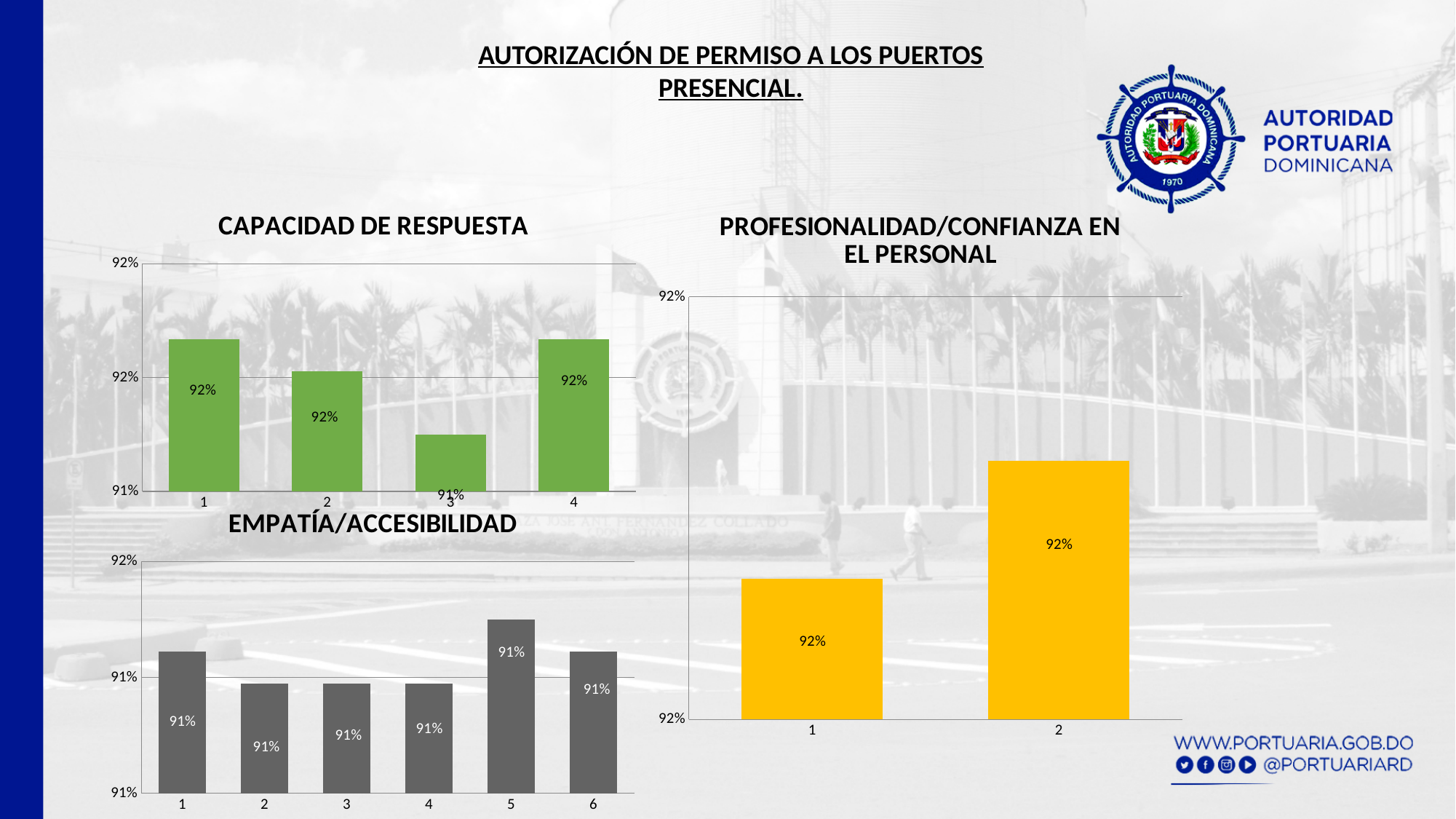
In the EMPATÍA/ACCESIBILIDAD chart, what is the value for category 6? 91% In the PROFESIONALIDAD/CONFIANZA EN EL PERSONAL chart, which bar is taller, category 1 or category 2? 2 In the EMPATÍA/ACCESIBILIDAD chart, is the bar for category 5 taller or shorter than the bar for category 2? taller In the EMPATÍA/ACCESIBILIDAD chart, which category has the highest bar? 5 How many bars are in the PROFESIONALIDAD/CONFIANZA EN EL PERSONAL chart? 2 In the CAPACIDAD DE RESPUESTA chart, which category has the lowest bar? 3 How many categories are shown in the EMPATÍA/ACCESIBILIDAD chart? 6 In the CAPACIDAD DE RESPUESTA chart, what is the value for category 3? 91% How many bars are in the CAPACIDAD DE RESPUESTA chart? 4 In the PROFESIONALIDAD/CONFIANZA EN EL PERSONAL chart, what is the value for category 2? 92% In the CAPACIDAD DE RESPUESTA chart, what is the value for category 1? 92% What type of chart is the EMPATÍA/ACCESIBILIDAD chart? bar chart